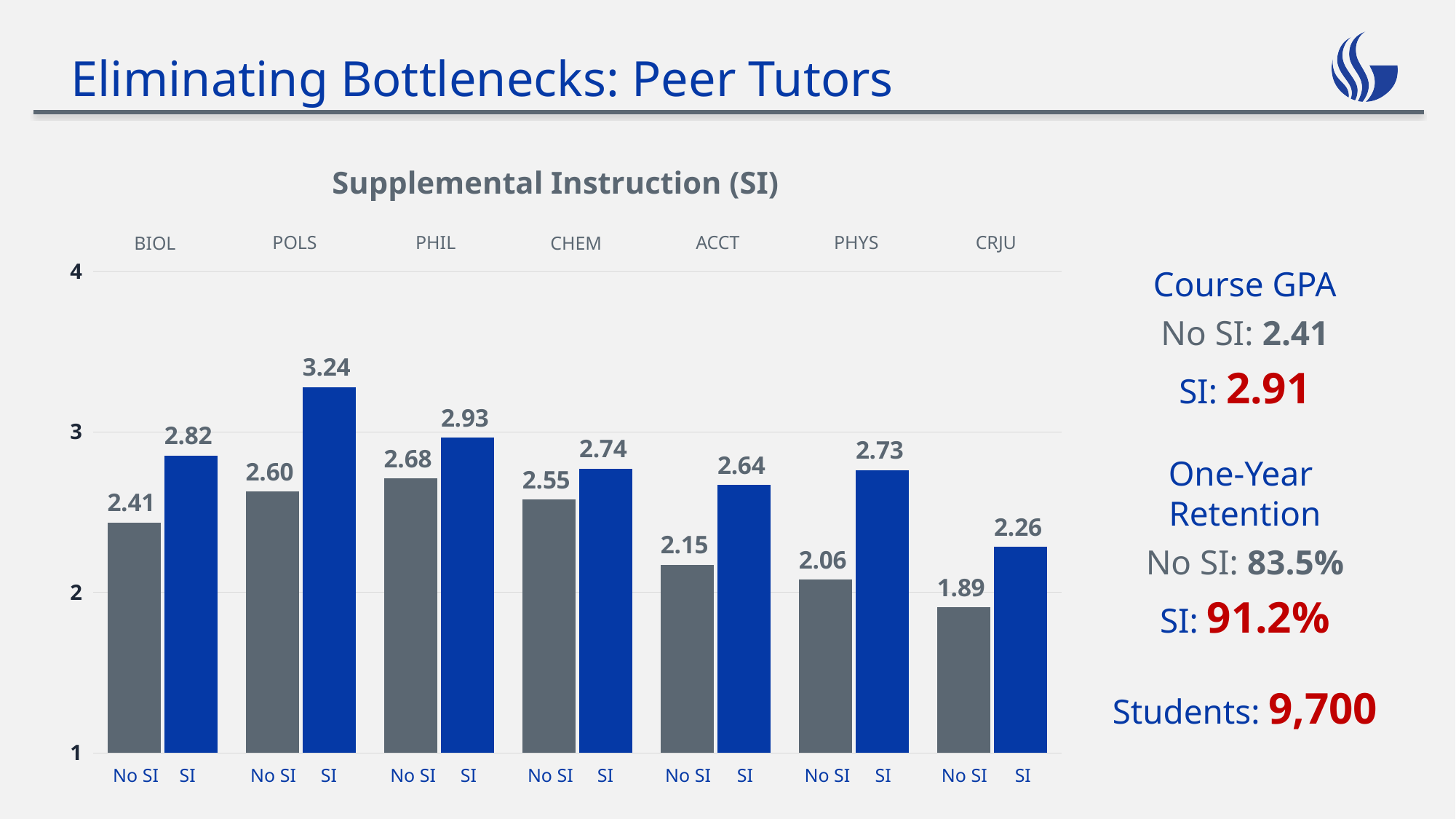
Is the SI value for BIOL greater or less than 3? less What colour are the SI bars? blue What kind of chart is shown on the slide? bar chart How many courses are shown on the chart? 7 What is the No SI value for CRJU? 1.89 Which is larger, the SI value for CHEM or the SI value for PHIL? PHIL What is the difference between the SI and No SI values for PHYS? 0.67 What is the No SI value for ACCT? 2.15 What is the title of the chart? Supplemental Instruction (SI) Which course has the highest SI value? POLS Which course has the lowest No SI value? CRJU What is the SI value for POLS? 3.24